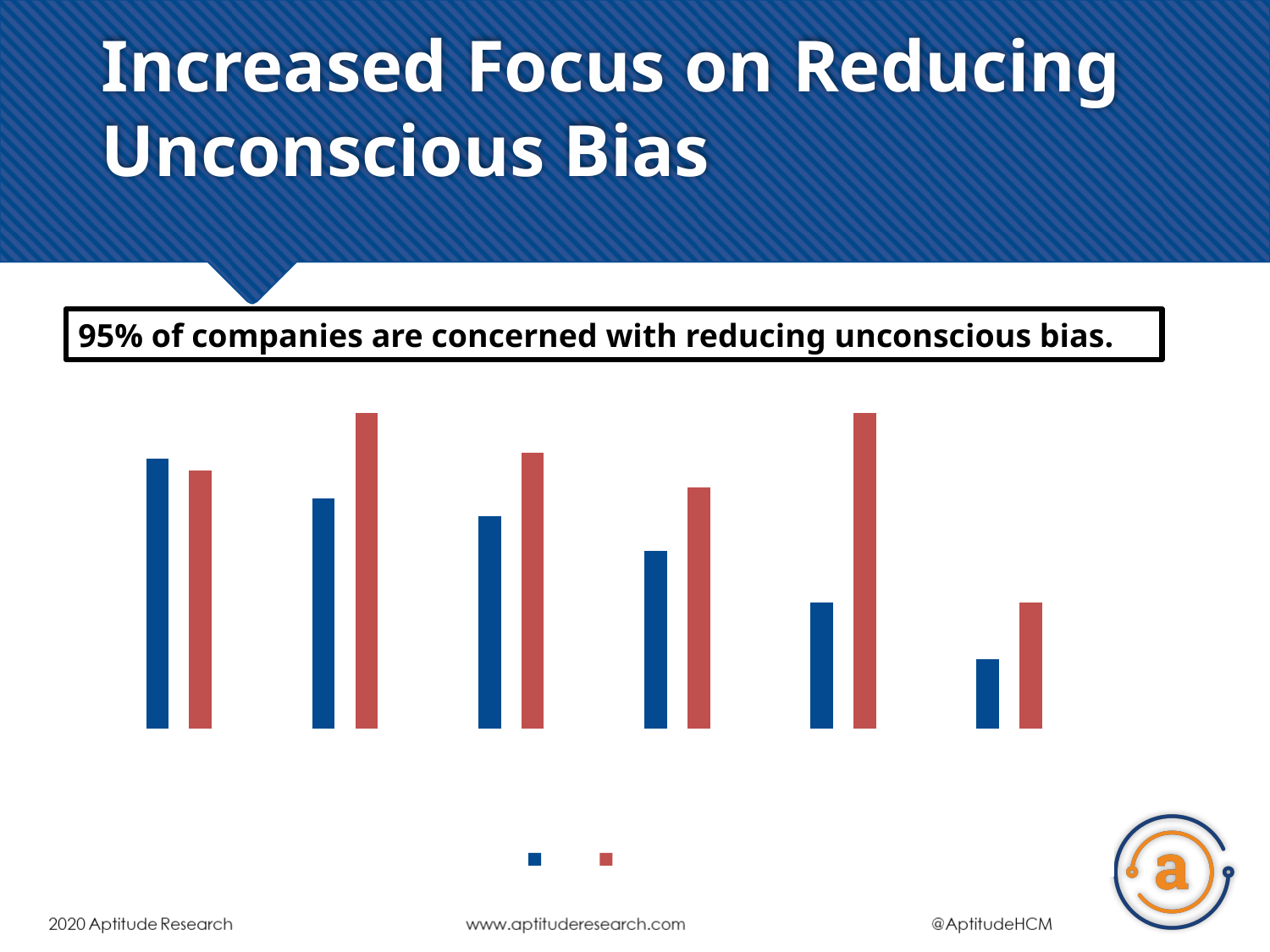
Which group of bars, counted from the left, has the tallest blue bar? the first In the fifth group of bars from the left, which bar is taller, the blue one or the red one? the red one How many groups of bars (categories) does the chart show? 6 In the second group of bars from the left, which bar is taller, the blue one or the red one? the red one How many series does the chart plot? 2 What kind of chart is shown on the slide? bar chart What two colours are used for the bars in the chart? blue and red What statement is shown in the box above the chart? 95% of companies are concerned with reducing unconscious bias. In the sixth group of bars from the left, which bar is taller, the blue one or the red one? the red one Do the blue bars rise or fall from left to right across the chart? fall Which group of bars, counted from the left, has the shortest blue bar? the sixth Which group of bars, counted from the left, has the shortest red bar? the sixth